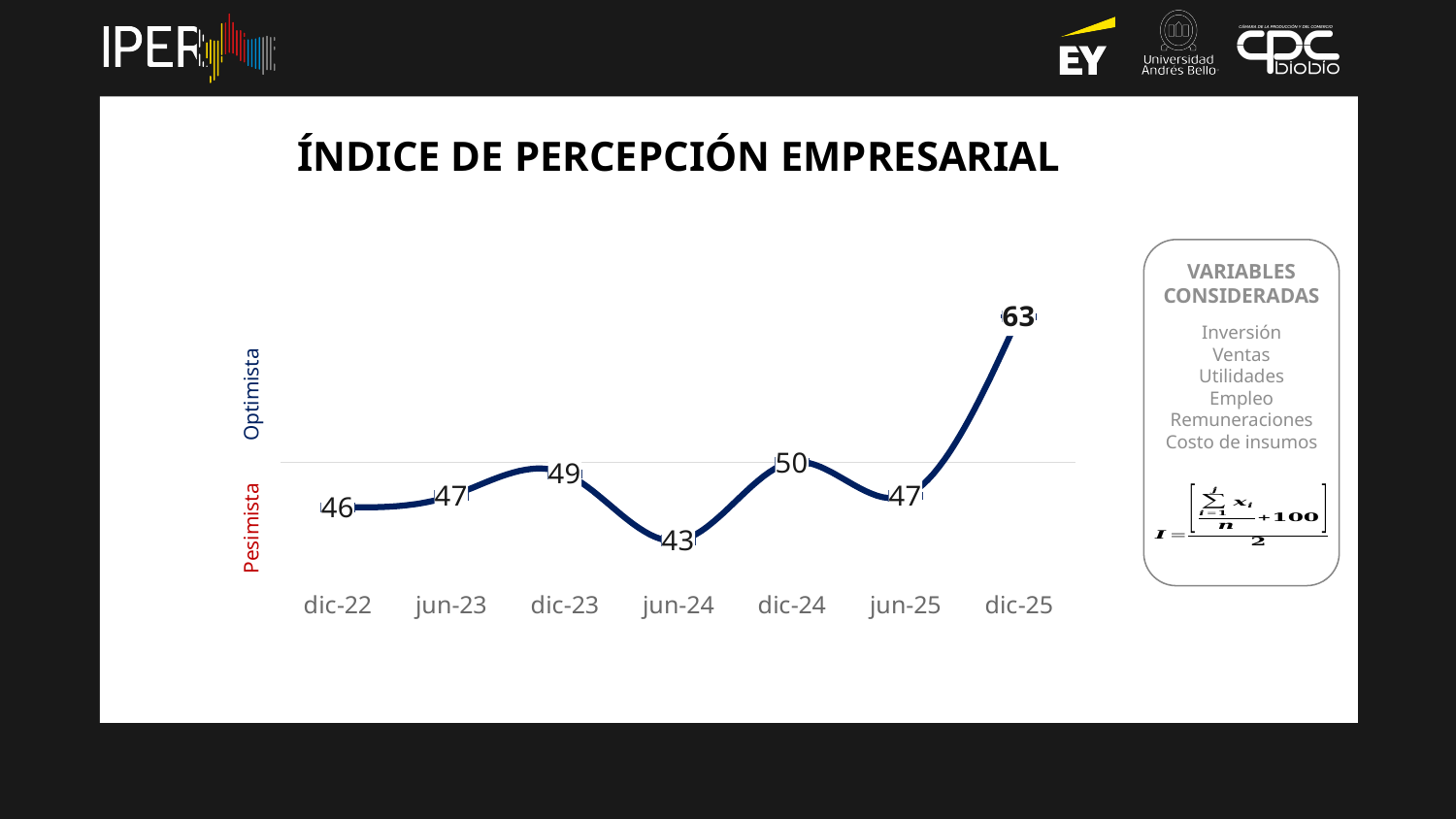
What is the value of the index for dic-25? 63 What is the difference between the index values for dic-25 and jun-25? 16 What is the title of the chart? ÍNDICE DE PERCEPCIÓN EMPRESARIAL What kind of chart is shown on the slide? line chart Which period has the highest index value? dic-25 Which is larger, the index value for dic-23 or for jun-23? dic-23 Which period has the lowest index value? jun-24 What is the value of the index for dic-22? 46 What is the value of the index for dic-24? 50 What is the value of the index for jun-24? 43 How many periods are plotted on the chart? 7 What is the difference between the index values for dic-24 and jun-24? 7